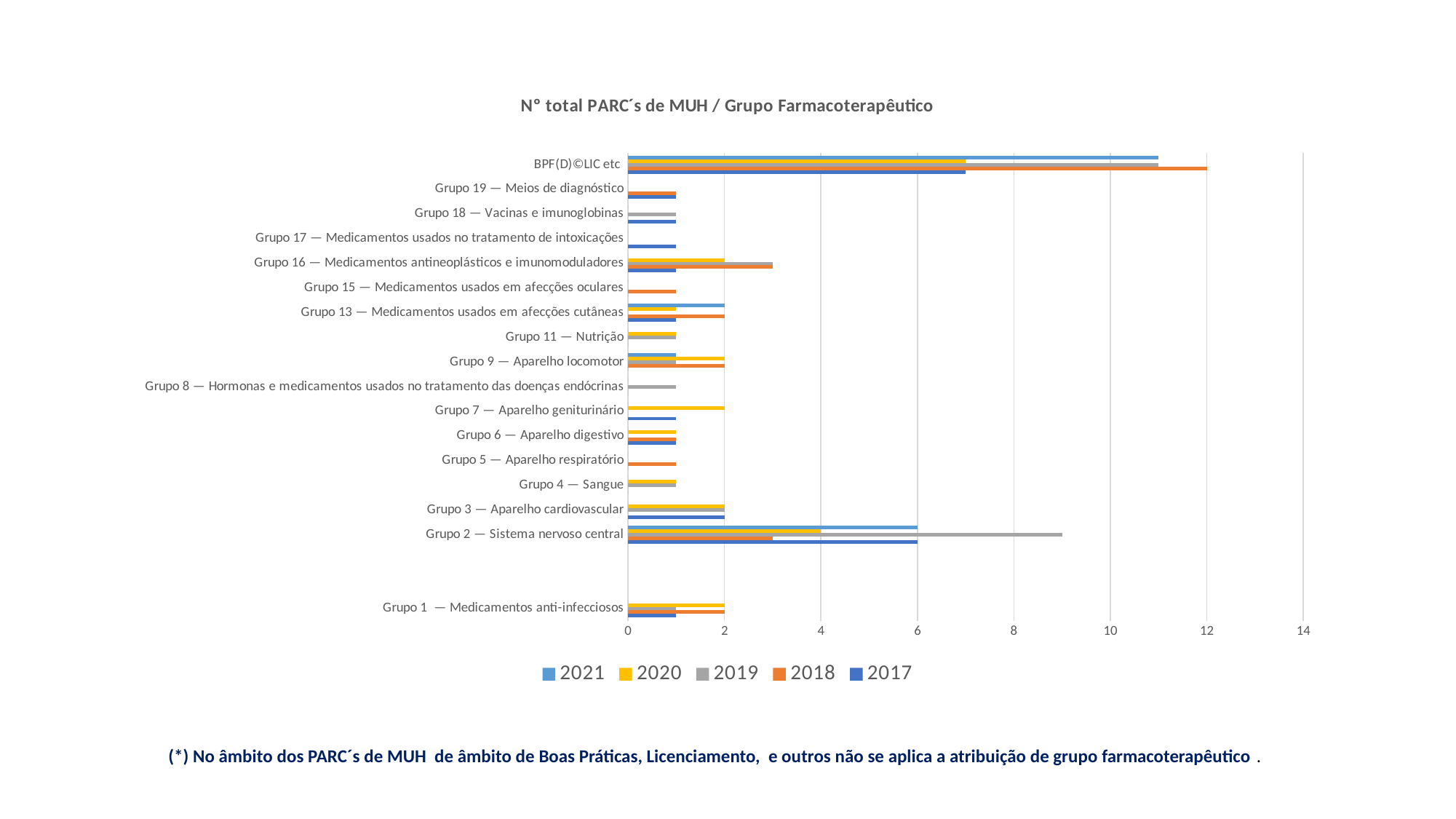
Is the 2021 value for BPF(D)©LIC etc greater or less than 10? greater What is the title of the chart? Nº total PARC´s de MUH / Grupo Farmacoterapêutico How many categories are shown on the vertical axis of the chart? 17 Which category has the highest 2018 value? BPF(D)©LIC etc What is the 2020 value for Grupo 2 — Sistema nervoso central? 4 Is the 2019 value for Grupo 2 — Sistema nervoso central greater or less than 8? greater What kind of chart is shown on the slide? bar chart What is the difference between the 2021 and 2020 values for Grupo 2 — Sistema nervoso central? 2 For Grupo 2 — Sistema nervoso central, which series has the larger value: 2019 or 2021? 2019 What is the 2018 value for BPF(D)©LIC etc? 12 What is the 2021 value for Grupo 2 — Sistema nervoso central? 6 How many series does the legend list? 5